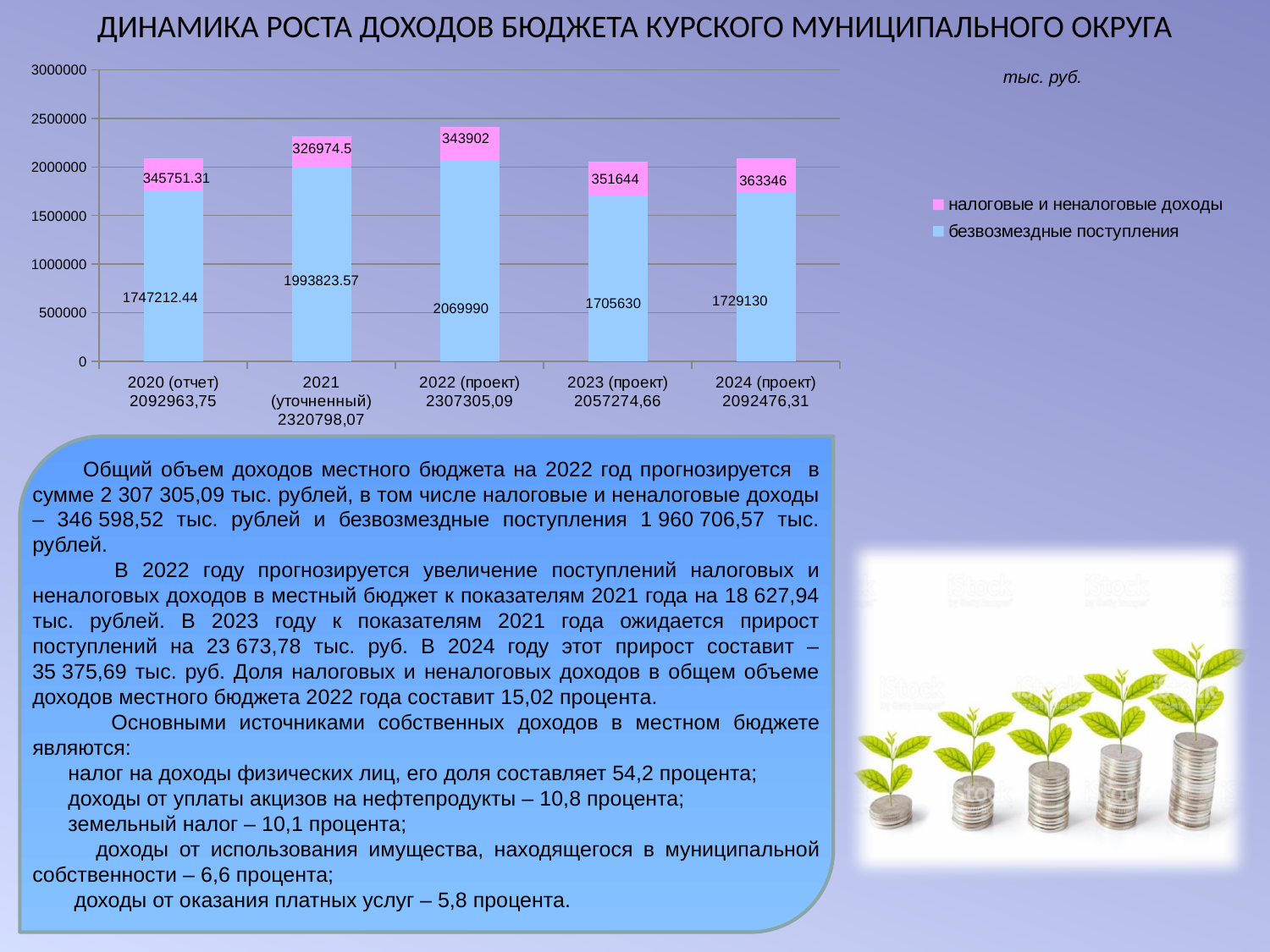
Which is larger: the 'налоговые и неналоговые доходы' value for 2020 (отчет) or for 2022 (проект)? 2020 (отчет) What unit is indicated in the top right of the chart? тыс. руб. In which year is the 'налоговые и неналоговые доходы' value the lowest? 2021 (уточненный) What is the value of the 'безвозмездные поступления' series for 2021 (уточненный)? 1993823.57 What kind of chart is shown on the slide? stacked bar chart What is the total of the stacked bar for 2021 (уточненный), as printed on the x axis label? 2320798,07 What is the value of the 'налоговые и неналоговые доходы' series for 2024 (проект)? 363346 In which year is the 'безвозмездные поступления' value the highest? 2022 (проект) How many series does the chart legend list? 2 What is the value of the 'безвозмездные поступления' series for 2022 (проект)? 2069990 What is the difference between the 'безвозмездные поступления' values for 2024 (проект) and 2023 (проект)? 23500 How many year categories are shown on the x axis of the chart? 5